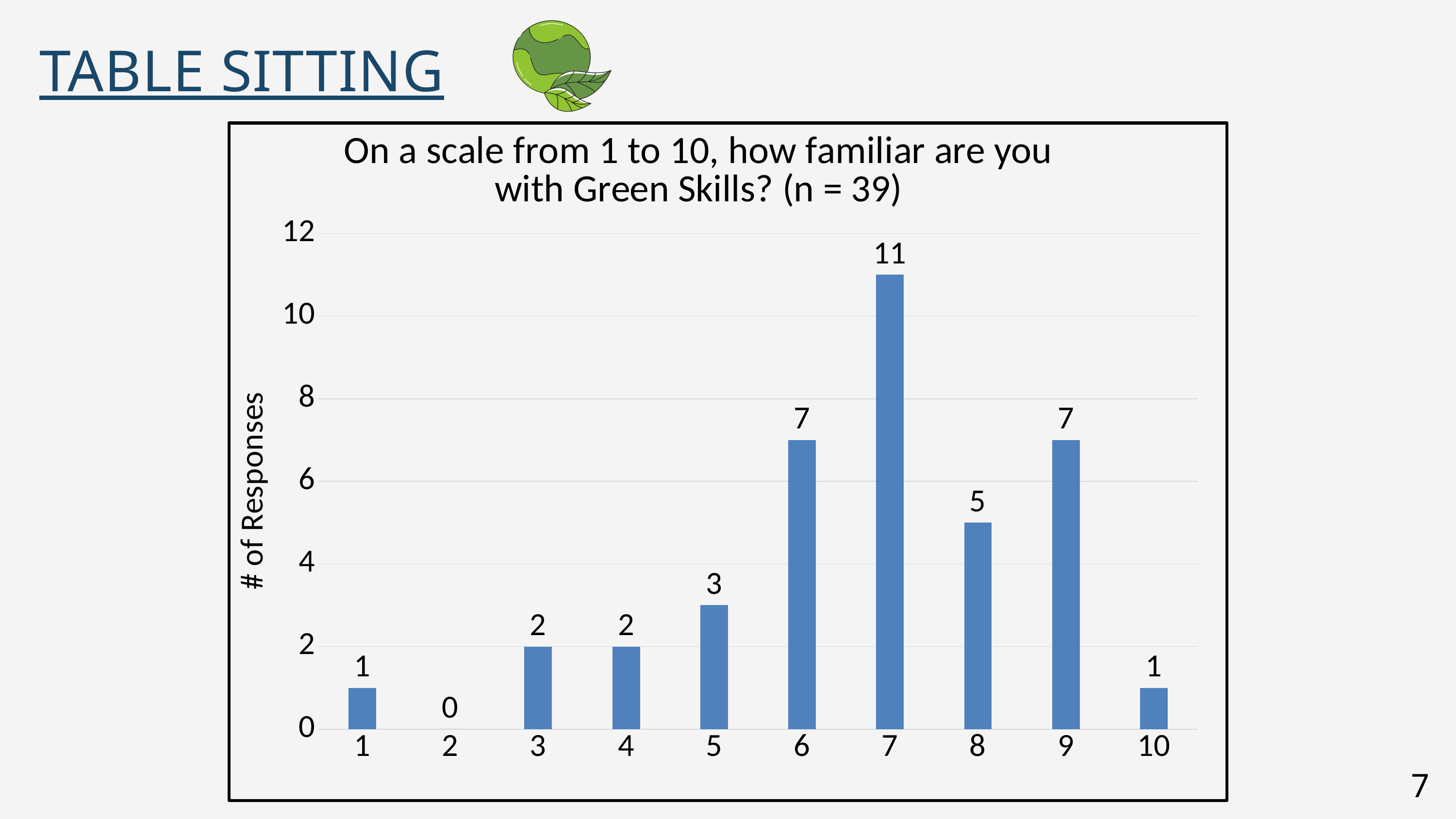
How many respondents (n) does the chart title state? 39 What is the difference in the number of responses between rating 7 and rating 8? 6 How many responses were recorded for a familiarity rating of 5? 3 What is the combined number of responses for ratings 9 and 10? 8 Which familiarity rating received the most responses? 7 Which rating received more responses, 6 or 8? 6 What is the label of the y axis? # of Responses How many rating categories are shown on the x axis? 10 How many responses were recorded for a familiarity rating of 2? 0 Which familiarity rating received the fewest responses? 2 How many responses were recorded for a familiarity rating of 7? 11 What kind of chart is shown on the slide? Bar chart